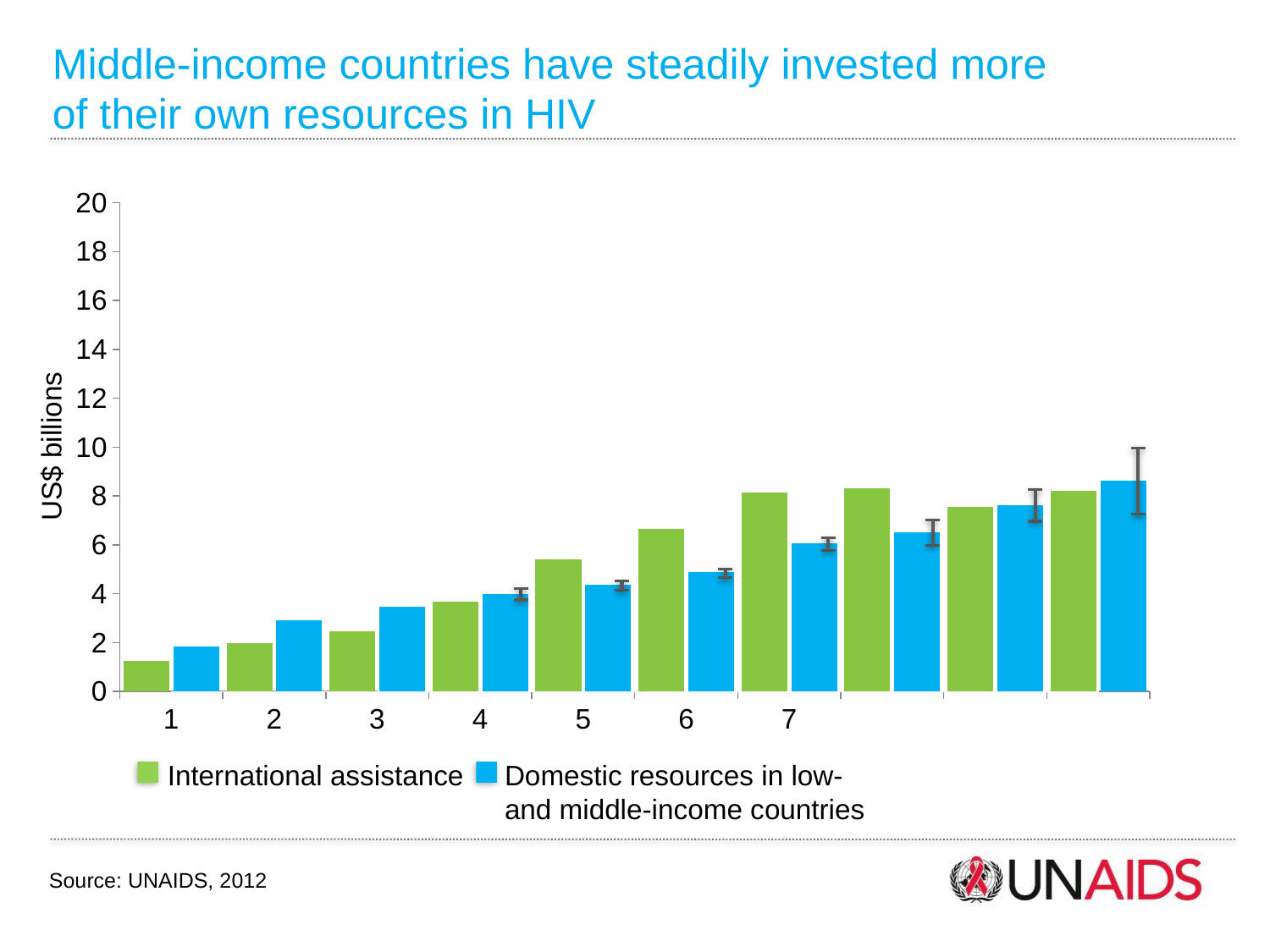
Is the International assistance value for category 6 greater or less than 6? greater How many series does the legend list? 2 What is the label on the vertical axis? US$ billions Is the Domestic resources value for category 6 greater or less than 6? less Is the International assistance value for category 1 greater or less than 2? less For category 1, which is larger: International assistance or Domestic resources? Domestic resources What are the two series named in the legend? International assistance; Domestic resources in low- and middle-income countries Do the Domestic resources values rise or fall from left to right along the x axis? Rise How many green (International assistance) bars are plotted? 10 For category 7, which is larger: International assistance or Domestic resources? International assistance What kind of chart is shown on the slide? Bar chart